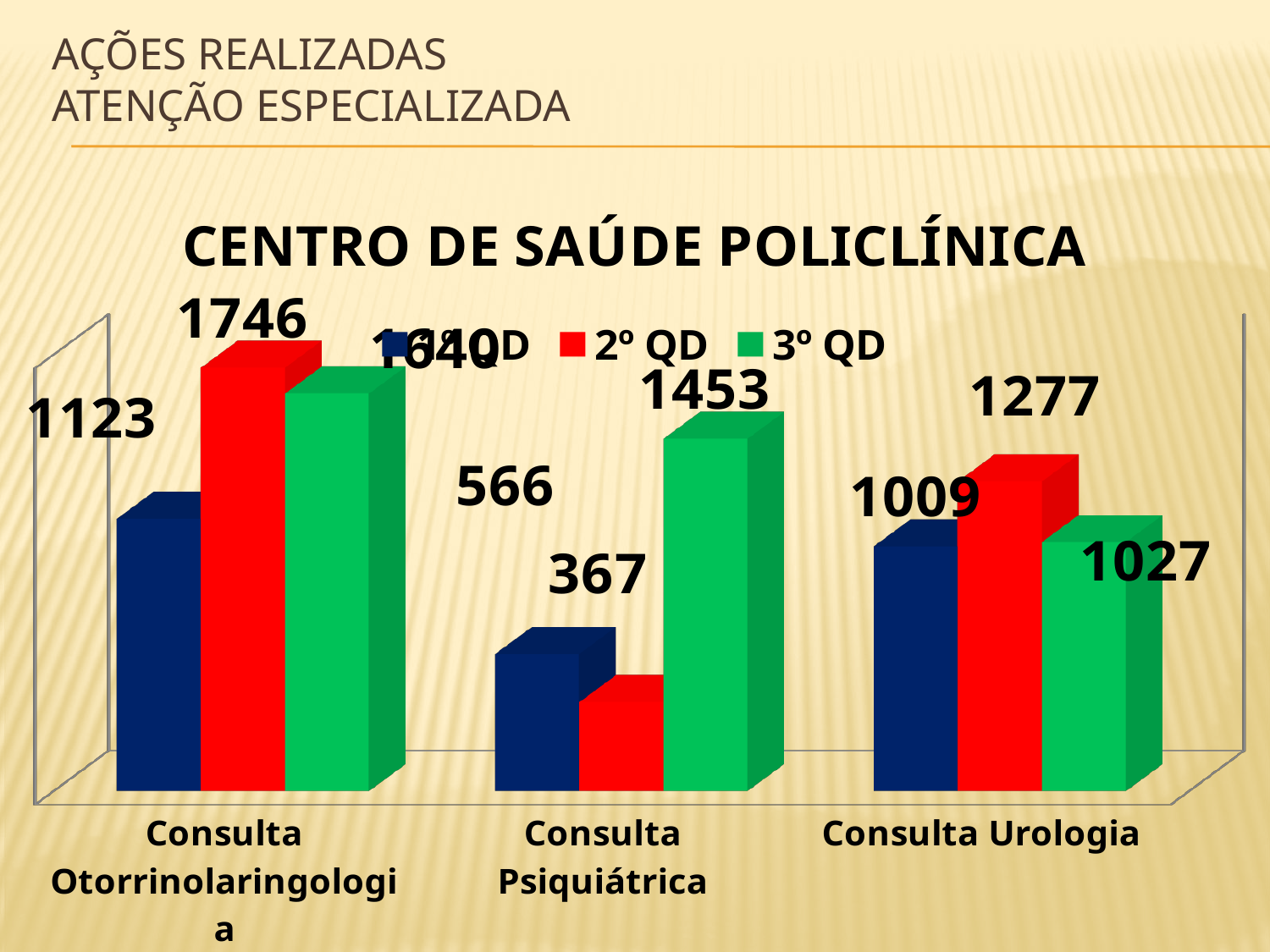
What is the value for 1º QD in Consulta Otorrinolaringologia? 1123 How many series does the legend list? 3 What is the value for 3º QD in Consulta Urologia? 1027 Which category has the highest value for 2º QD? Consulta Otorrinolaringologia What is the difference between the 2º QD and 1º QD values in Consulta Urologia? 268 What is the value for 2º QD in Consulta Psiquiátrica? 367 What is the value for 3º QD in Consulta Psiquiátrica? 1453 What is the value for 2º QD in Consulta Otorrinolaringologia? 1746 What is the value for 1º QD in Consulta Urologia? 1009 What is the title of the chart? CENTRO DE SAÚDE POLICLÍNICA Which is larger in Consulta Psiquiátrica: the 1º QD value or the 2º QD value? 1º QD Which category has the lowest value for 2º QD? Consulta Psiquiátrica